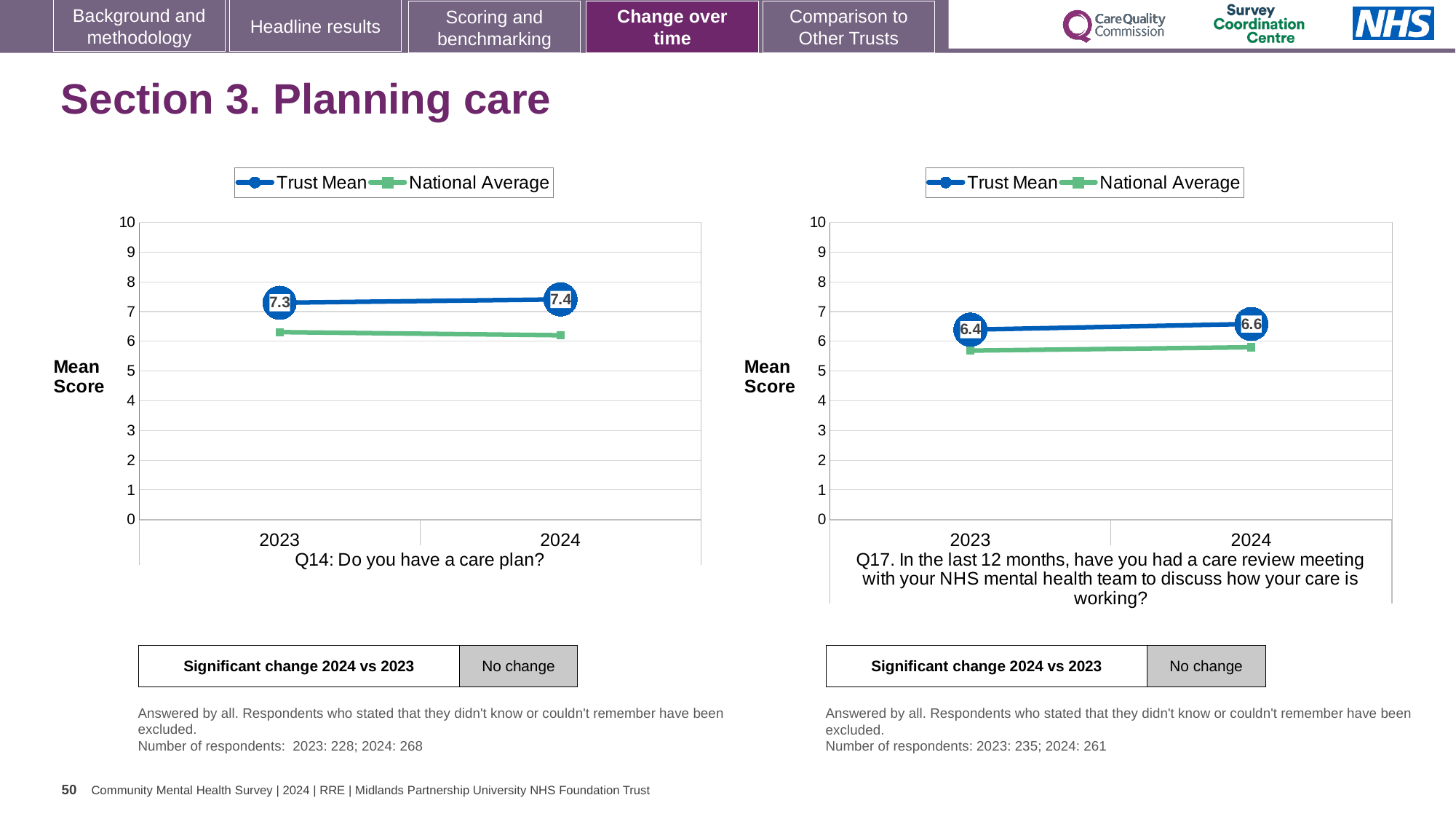
In the Q14 chart (left), what is the Trust Mean score for 2024? 7.4 In the Q17 chart (right), what is the difference between the Trust Mean scores for 2024 and 2023? 0.2 In the Q14 chart (left), is the National Average for 2024 greater or less than 7? less In the Q14 chart (left), does the Trust Mean rise or fall from 2023 to 2024? rise In the Q17 chart (right), what is the Trust Mean score for 2023? 6.4 In the Q17 chart (right), is the National Average for 2023 greater or less than 6? less In the Q14 chart (left), which series is higher in 2024, Trust Mean or National Average? Trust Mean In the Q14 chart (left), what is the Trust Mean score for 2023? 7.3 In the Q17 chart (right), what is the Trust Mean score for 2024? 6.6 How many years are plotted on the x axis of the Q14 chart (left)? 2 What kind of chart is the Q17 chart (right)? line chart How many series does the legend of the Q17 chart (right) list? 2